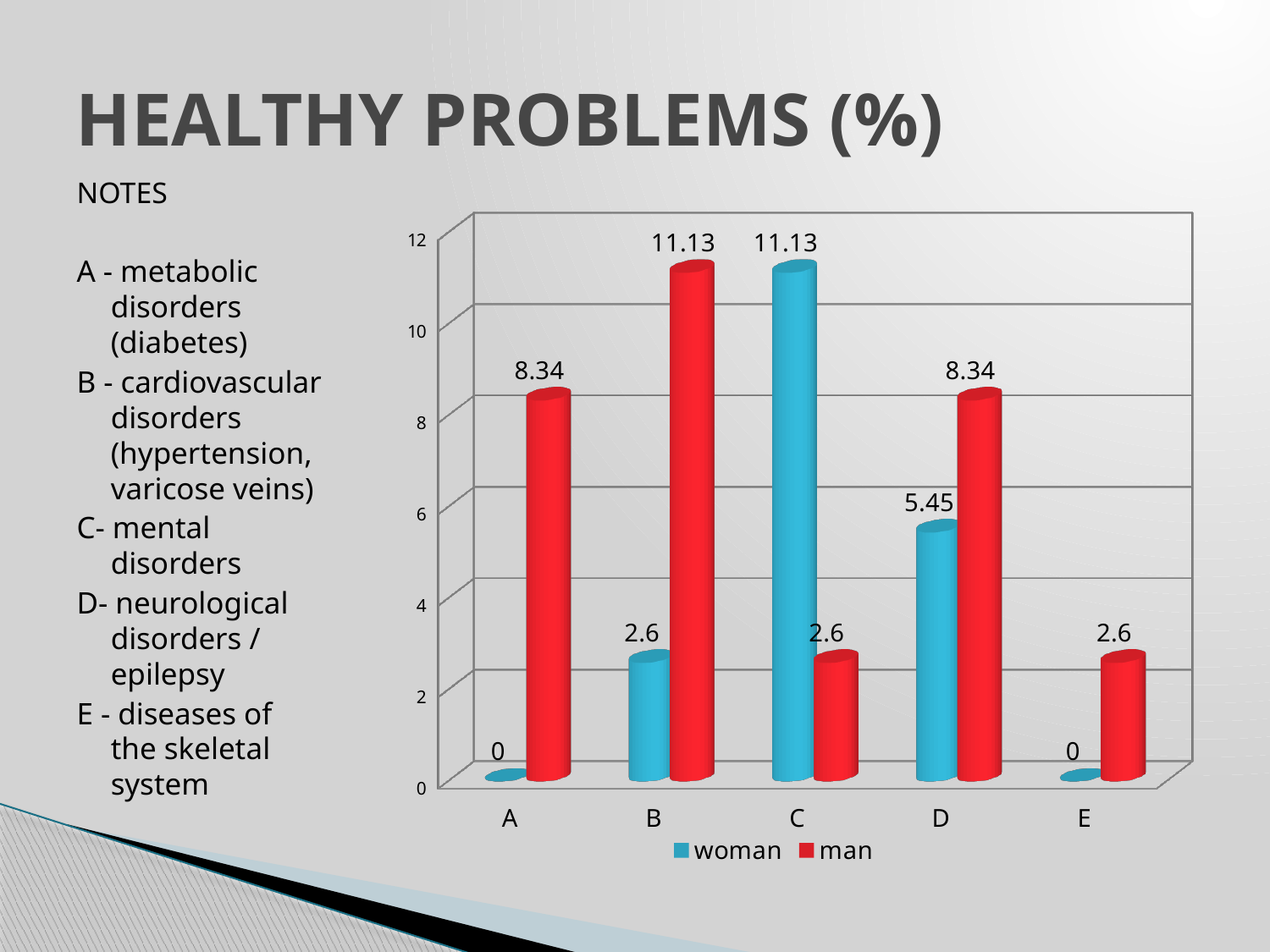
How many series does the legend list? 2 What is the title of the slide containing the chart? HEALTHY PROBLEMS (%) What is the value for woman in category D? 5.45 What is the value for man in category E? 2.6 How many categories are shown on the x axis? 5 What is the value for woman in category C? 11.13 What is the value for man in category A? 8.34 Which category has the highest value for the woman series? C What is the difference between the man and woman values in category D? 2.89 In category B, which is larger, the woman value or the man value? man What kind of chart is shown on the slide? bar chart Which category has the highest value for the man series? B